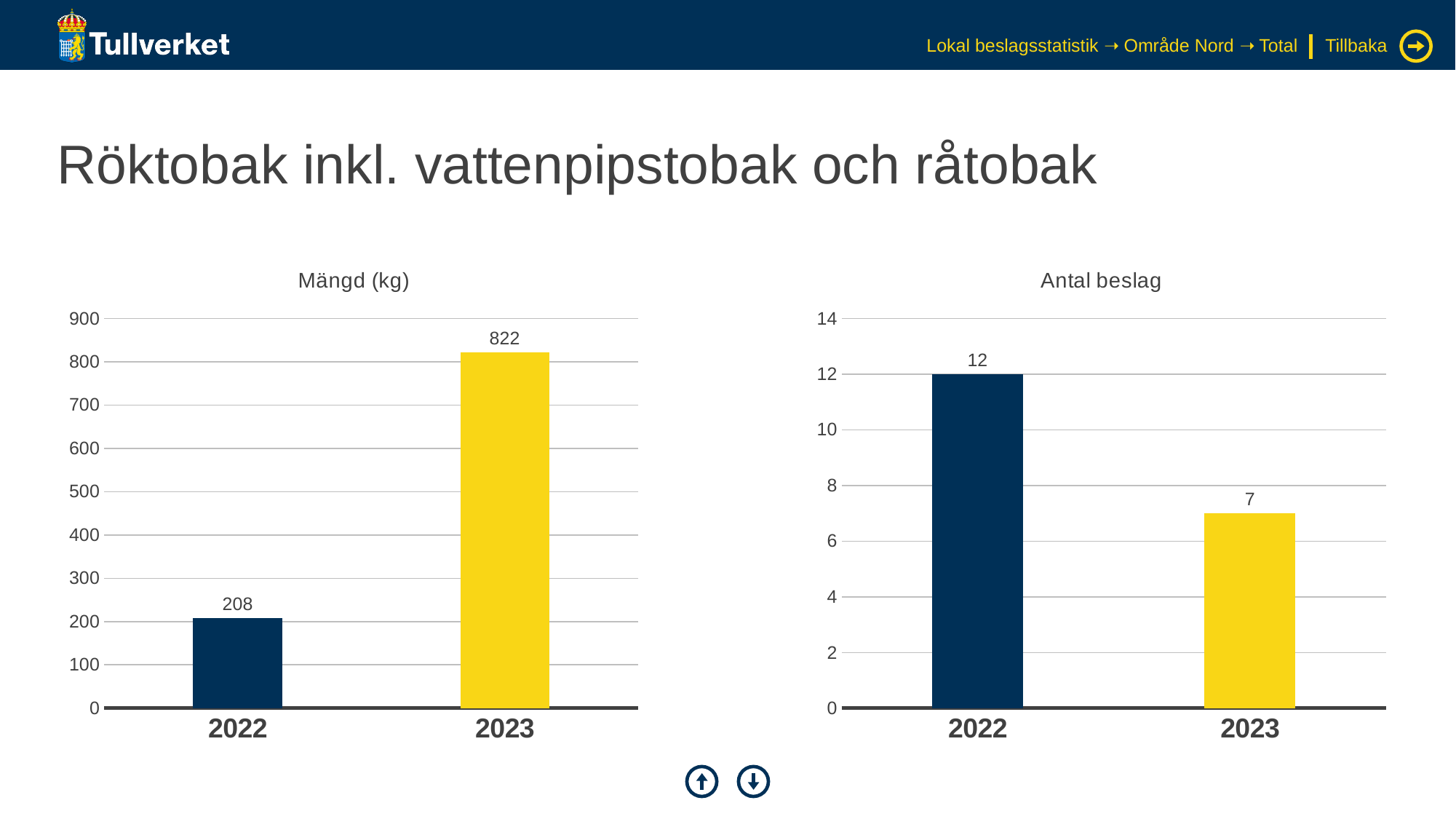
What kind of chart is the 'Mängd (kg)' chart? Bar chart In the 'Mängd (kg)' chart, which year has the highest value? 2023 In the 'Mängd (kg)' chart, what is the value for 2022? 208 In the 'Antal beslag' chart, which year has the lowest value? 2023 In the 'Antal beslag' chart, what is the value for 2022? 12 In the 'Antal beslag' chart, what is the difference between the 2022 and 2023 values? 5 In the 'Antal beslag' chart, what is the value for 2023? 7 In the 'Mängd (kg)' chart, what is the difference between the 2023 and 2022 values? 614 In the 'Antal beslag' chart, which is larger, the value for 2022 or 2023? 2022 In the 'Mängd (kg)' chart, is the value for 2023 greater or less than 800? greater How many categories are shown on the x axis of the 'Antal beslag' chart? 2 In the 'Mängd (kg)' chart, what is the value for 2023? 822